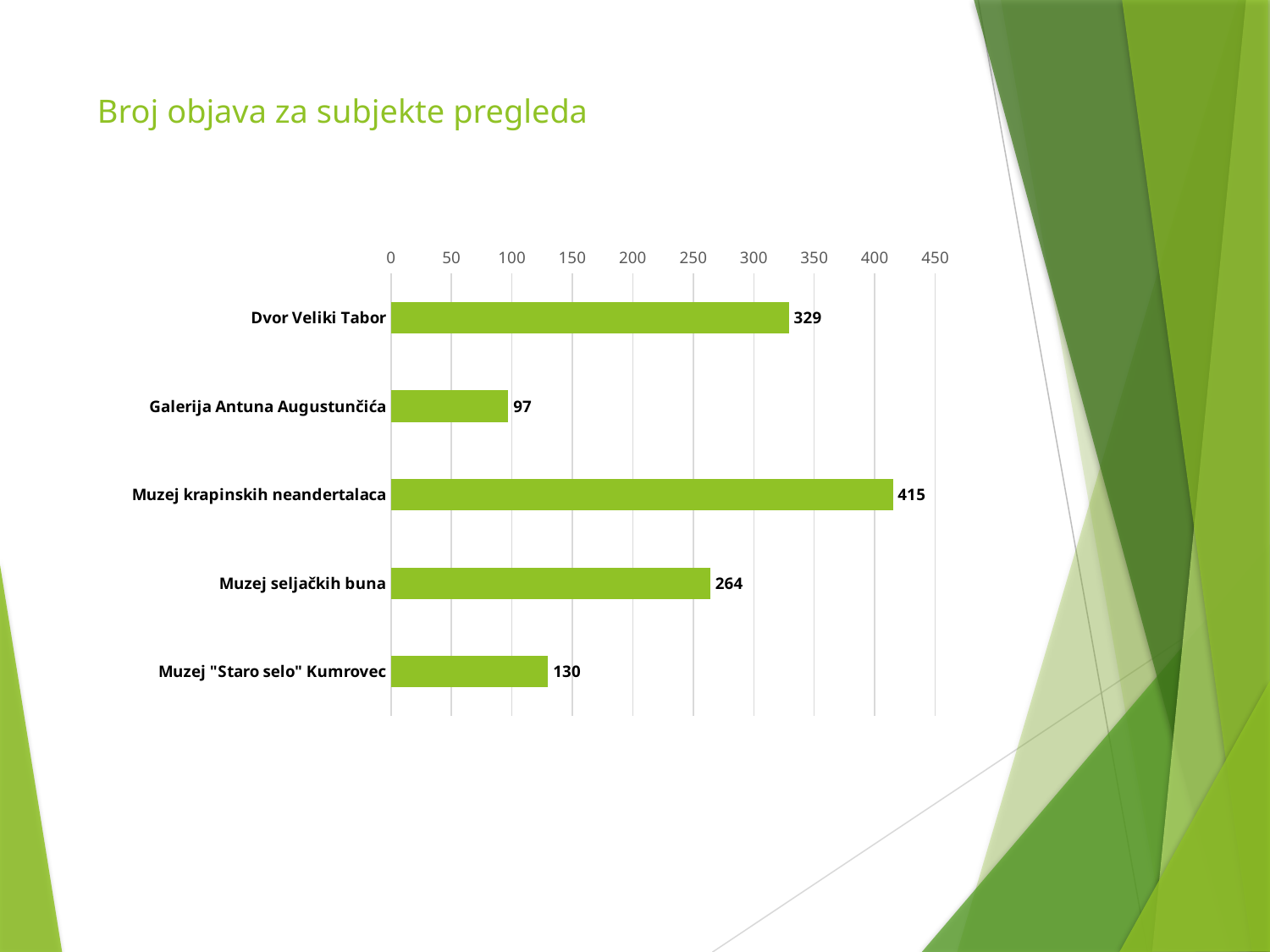
What is the title of the slide? Broj objava za subjekte pregleda What is the value for Muzej "Staro selo" Kumrovec? 130 Which category has the highest value? Muzej krapinskih neandertalaca What kind of chart is shown on the slide? bar chart What is the difference between the values for Dvor Veliki Tabor and Muzej "Staro selo" Kumrovec? 199 Is the value for Muzej seljačkih buna greater or less than 250? greater Which is larger, the value for Muzej seljačkih buna or the value for Dvor Veliki Tabor? Dvor Veliki Tabor Which category has the lowest value? Galerija Antuna Augustunčića What is the value for Dvor Veliki Tabor? 329 How many categories are shown in the chart? 5 What is the value for Galerija Antuna Augustunčića? 97 What is the difference between the values for Muzej krapinskih neandertalaca and Muzej seljačkih buna? 151